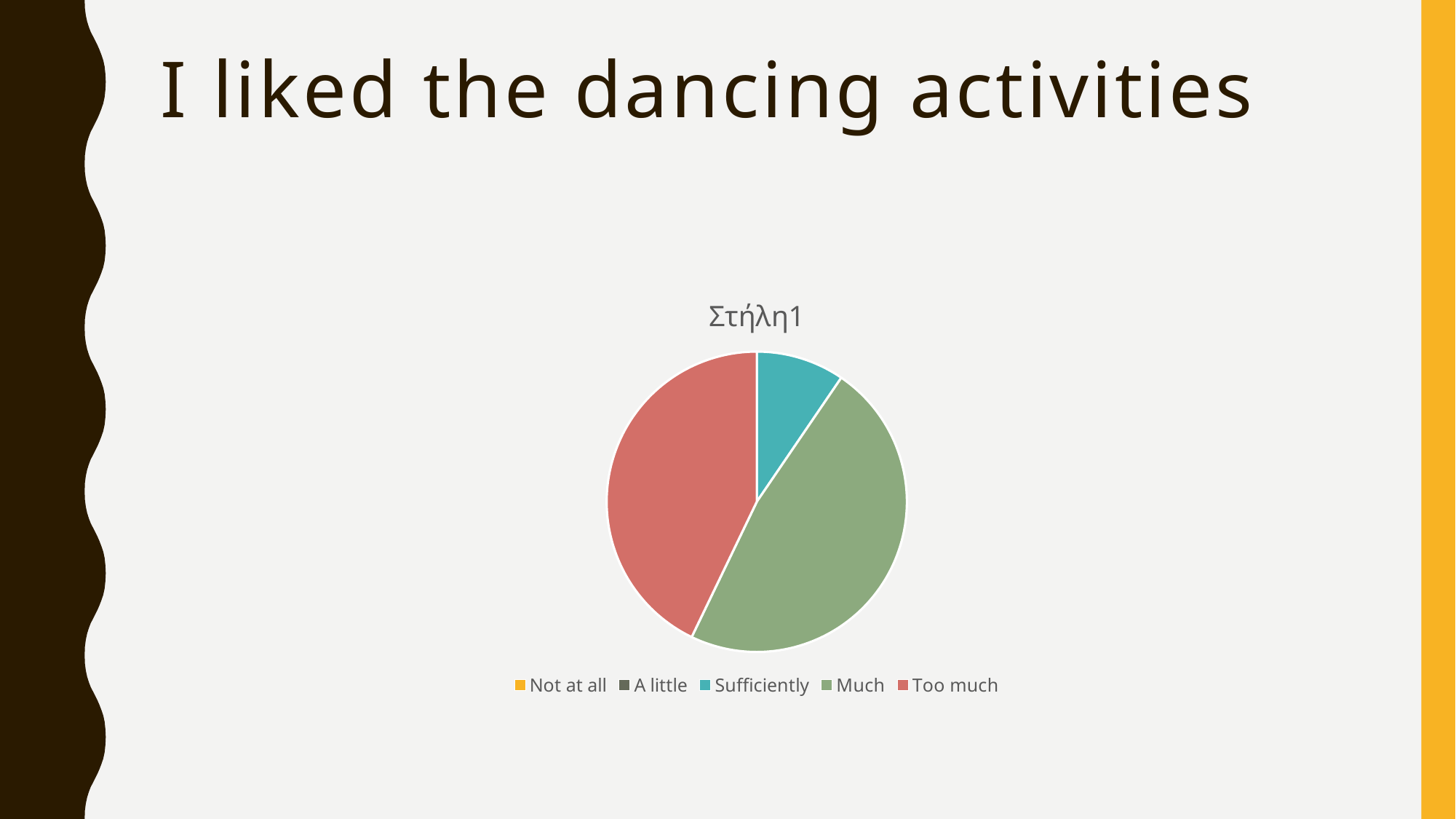
What colour is the slice for Too much in the pie chart? red What kind of chart is shown on the slide? pie chart Which is larger in the pie chart, the slice for Sufficiently or the slice for Much? Much How many entries does the chart legend list? 5 Which is larger in the pie chart, the slice for Too much or the slice for Sufficiently? Too much How many slices are visible in the pie chart? 3 What is the title printed above the pie chart? Στήλη1 Which visible slice of the pie chart is the smallest? Sufficiently